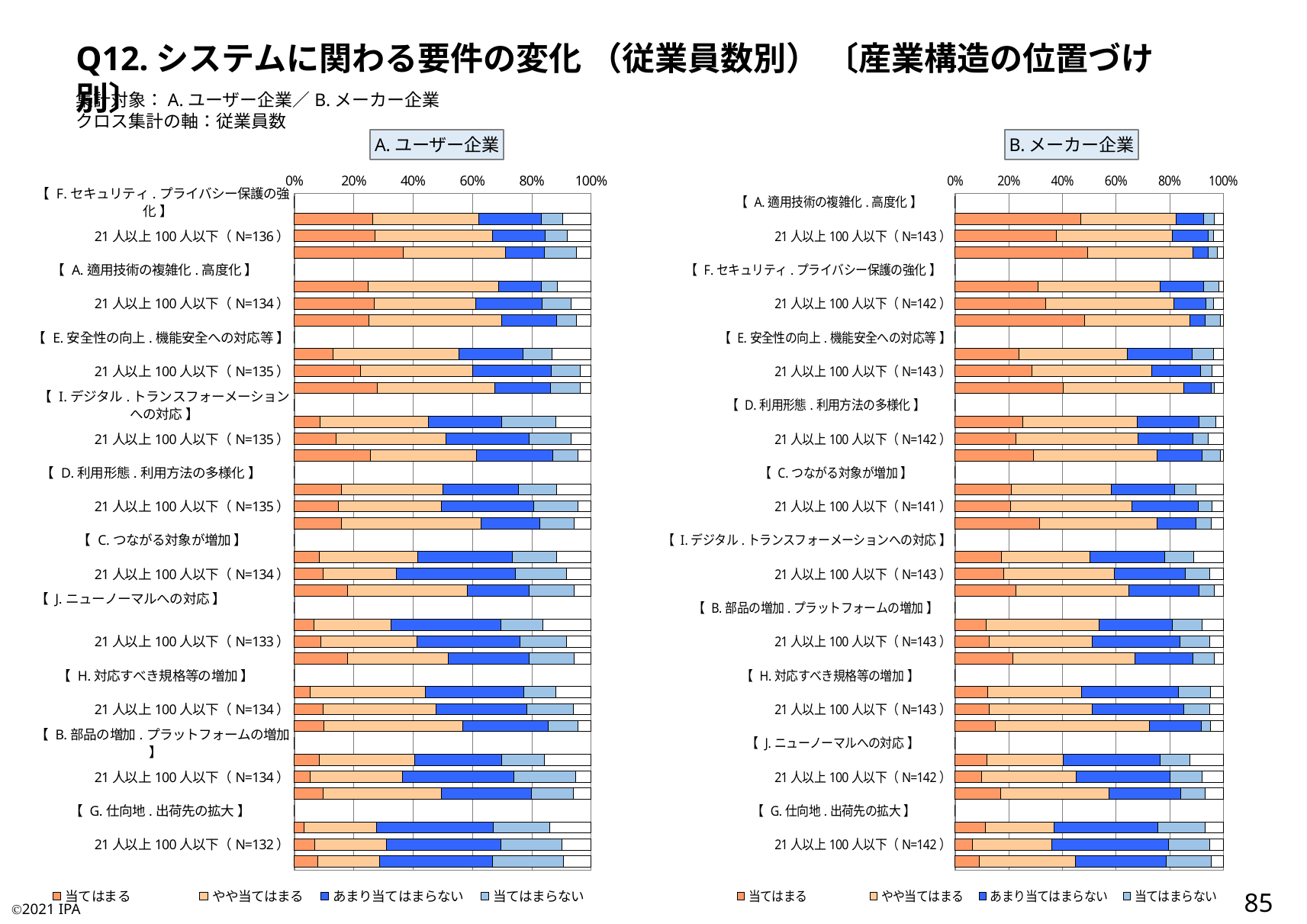
How many requirement categories (bracketed headings) are shown in the "A. ユーザー企業" chart? 10 What kind of chart is the "A. ユーザー企業" chart on the left? stacked bar chart How many series does the legend of the "B. メーカー企業" chart list? 4 In the "A. ユーザー企業" chart, is the 当てはまる share in the first bar under 【C. つながる対象が増加】 greater or less than 20%? less In the "B. メーカー企業" chart, is the 当てはまる share in the first bar under 【A. 適用技術の複雑化.高度化】 greater or less than 40%? greater In the "B. メーカー企業" chart, which requirement category is listed at the top? A. 適用技術の複雑化.高度化 In the "A. ユーザー企業" chart, what is the first legend entry? 当てはまる In the "B. メーカー企業" chart, is the 当てはまる share in the first bar under 【G. 仕向地.出荷先の拡大】 greater or less than 20%? less In the "B. メーカー企業" chart, in the first bar under 【A. 適用技術の複雑化.高度化】, which is larger: the 当てはまる segment or the 当てはまらない segment? 当てはまる In the "A. ユーザー企業" chart, in the first bar under 【G. 仕向地.出荷先の拡大】, which is larger: the 当てはまる segment or the あまり当てはまらない segment? あまり当てはまらない